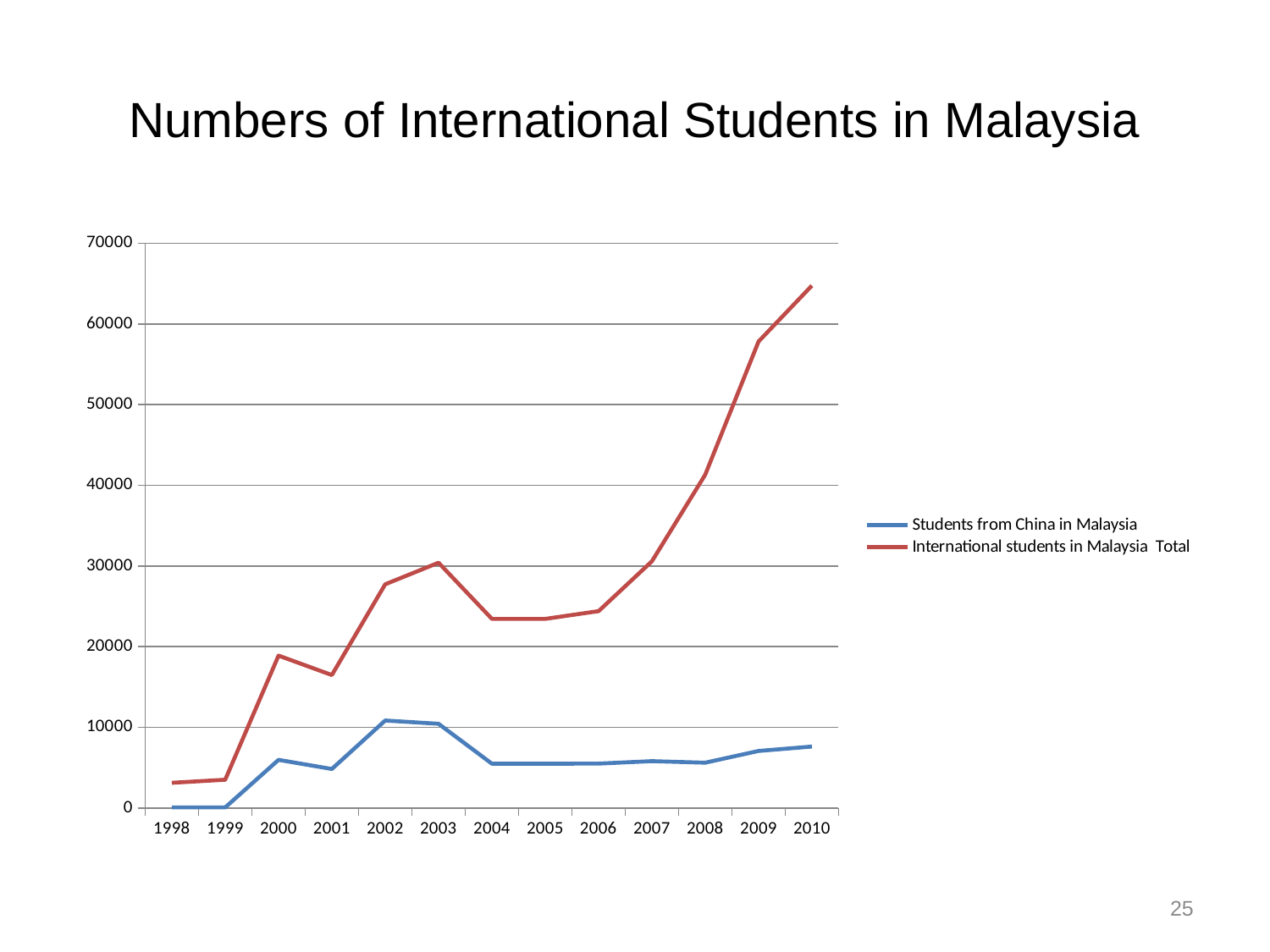
Is the value for International students in Malaysia Total in 2010 greater or less than 60000? greater Is the value for International students in Malaysia Total in 2009 greater or less than 60000? less In which year is the value for International students in Malaysia Total highest? 2010 Does the value for International students in Malaysia Total rise or fall from 2006 to 2010? rise Is the value for Students from China in Malaysia in 2010 greater or less than 10000? less In which year is the value for International students in Malaysia Total lowest? 1998 What is the title of the chart? Numbers of International Students in Malaysia How many series does the legend list? 2 In which year is the value for Students from China in Malaysia highest? 2002 What kind of chart is shown on the slide? line chart Which is larger for Students from China in Malaysia: the value in 2002 or the value in 2010? 2002 How many years are plotted along the x axis? 13